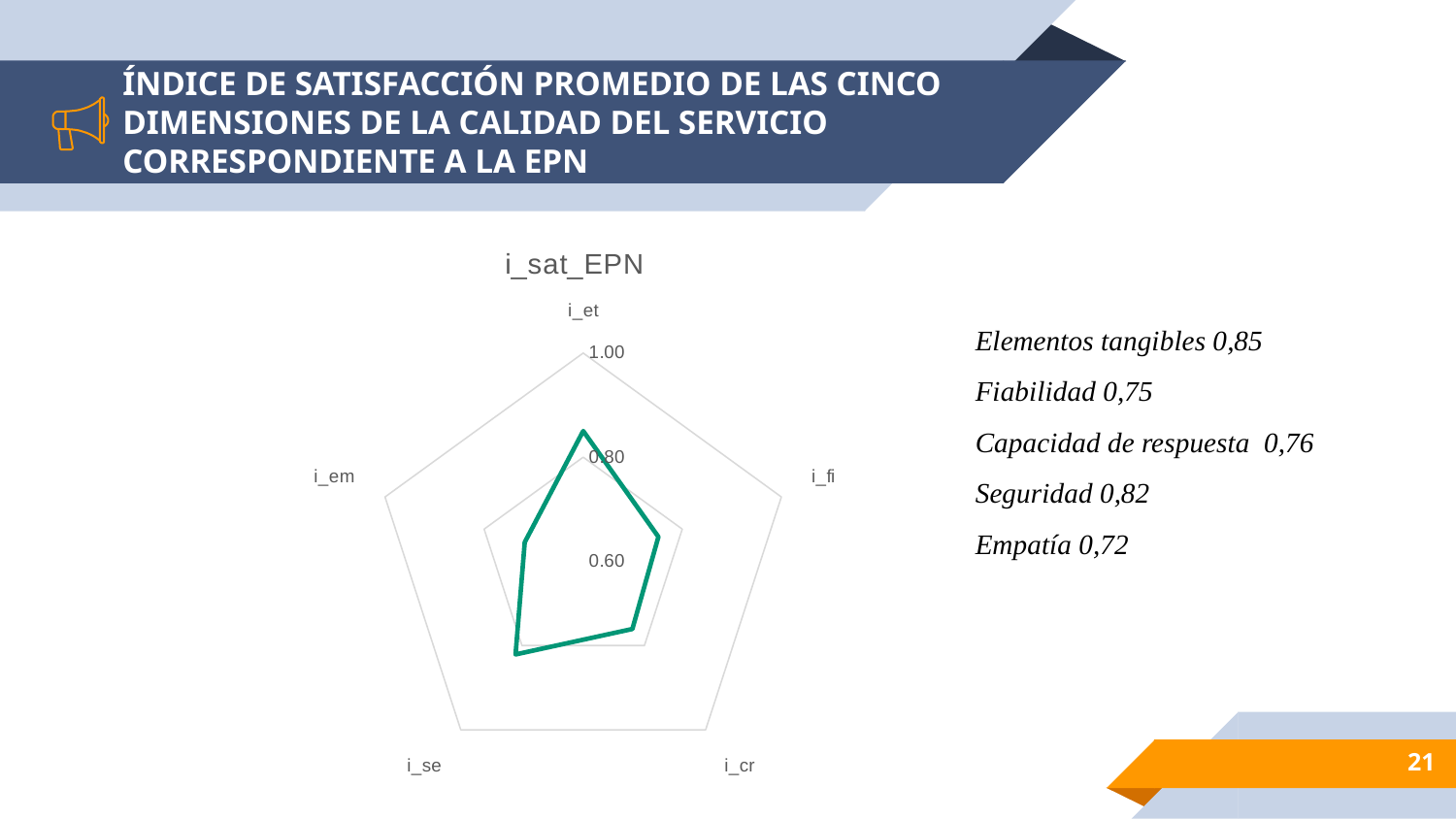
Is the value for i_em greater or less than 0.80? less Is the value for i_fi greater or less than 0.80? less According to the text beside the chart, what is the difference between the index for Elementos tangibles and the index for Empatía? 0,13 Is the value for i_cr greater or less than 0.80? less What type of chart is shown on the slide? radar chart According to the text beside the chart, what is the satisfaction index for Seguridad? 0,82 Which has the larger value on the radar chart, i_et or i_em? i_et What is the title of the chart? i_sat_EPN How many axes (categories) does the radar chart have? 5 According to the text beside the chart, what is the satisfaction index for Empatía? 0,72 What is the highest value shown on the radar chart's axis scale? 1.00